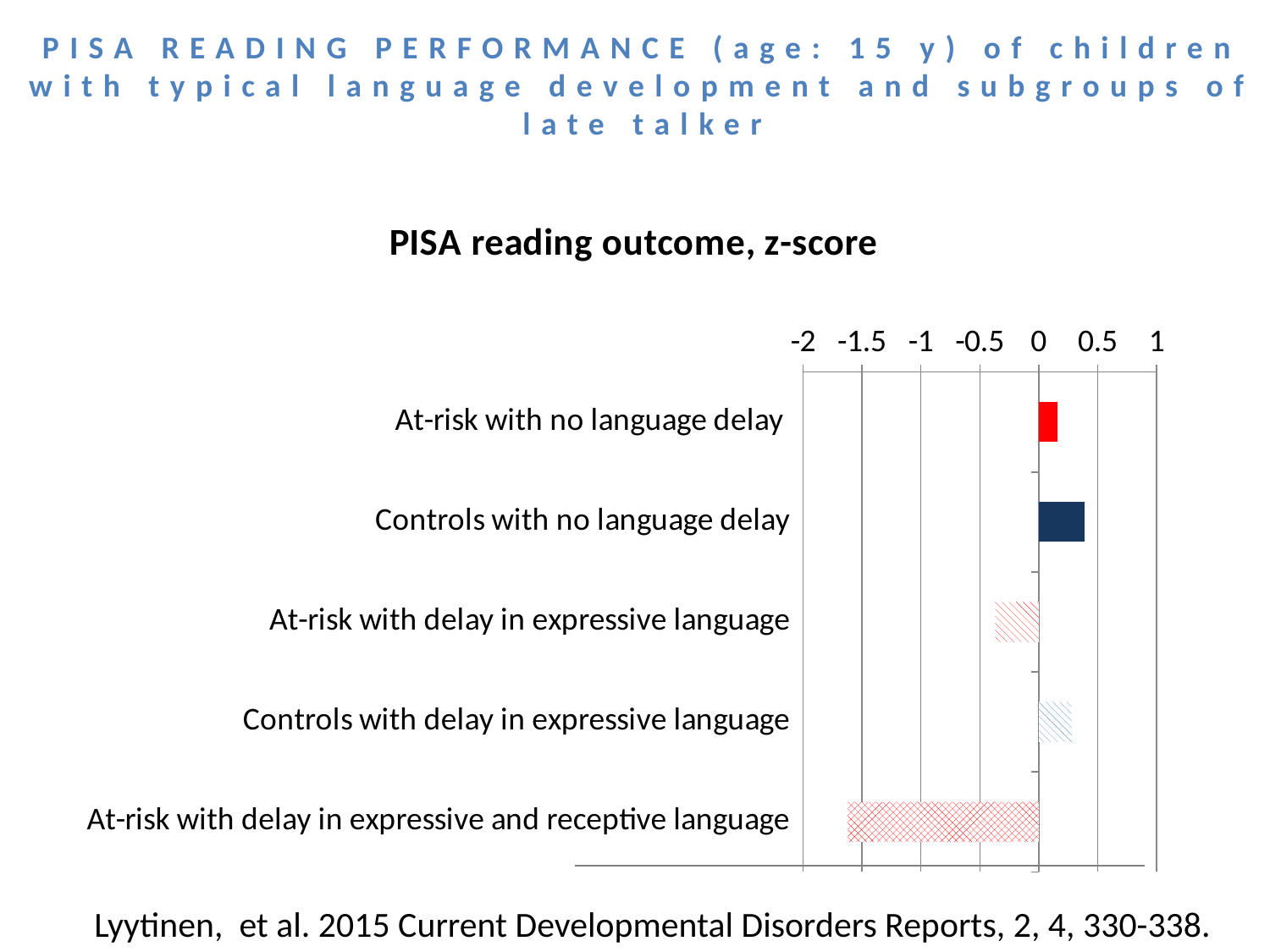
What is the title of the chart? PISA reading outcome, z-score Is the value for At-risk with delay in expressive and receptive language greater or less than -1? less Is the value for At-risk with delay in expressive language greater or less than 0? less Which group has the highest PISA reading z-score? Controls with no language delay Is the value for Controls with no language delay greater or less than 0.5? less Which group has the lowest PISA reading z-score? At-risk with delay in expressive and receptive language What kind of chart is shown on the slide? bar chart Which has the larger z-score: Controls with no language delay or At-risk with no language delay? Controls with no language delay What is the lowest value shown on the x axis of the chart? -2 How many groups have a negative z-score in the chart? 2 How many categories (groups) are plotted in the chart? 5